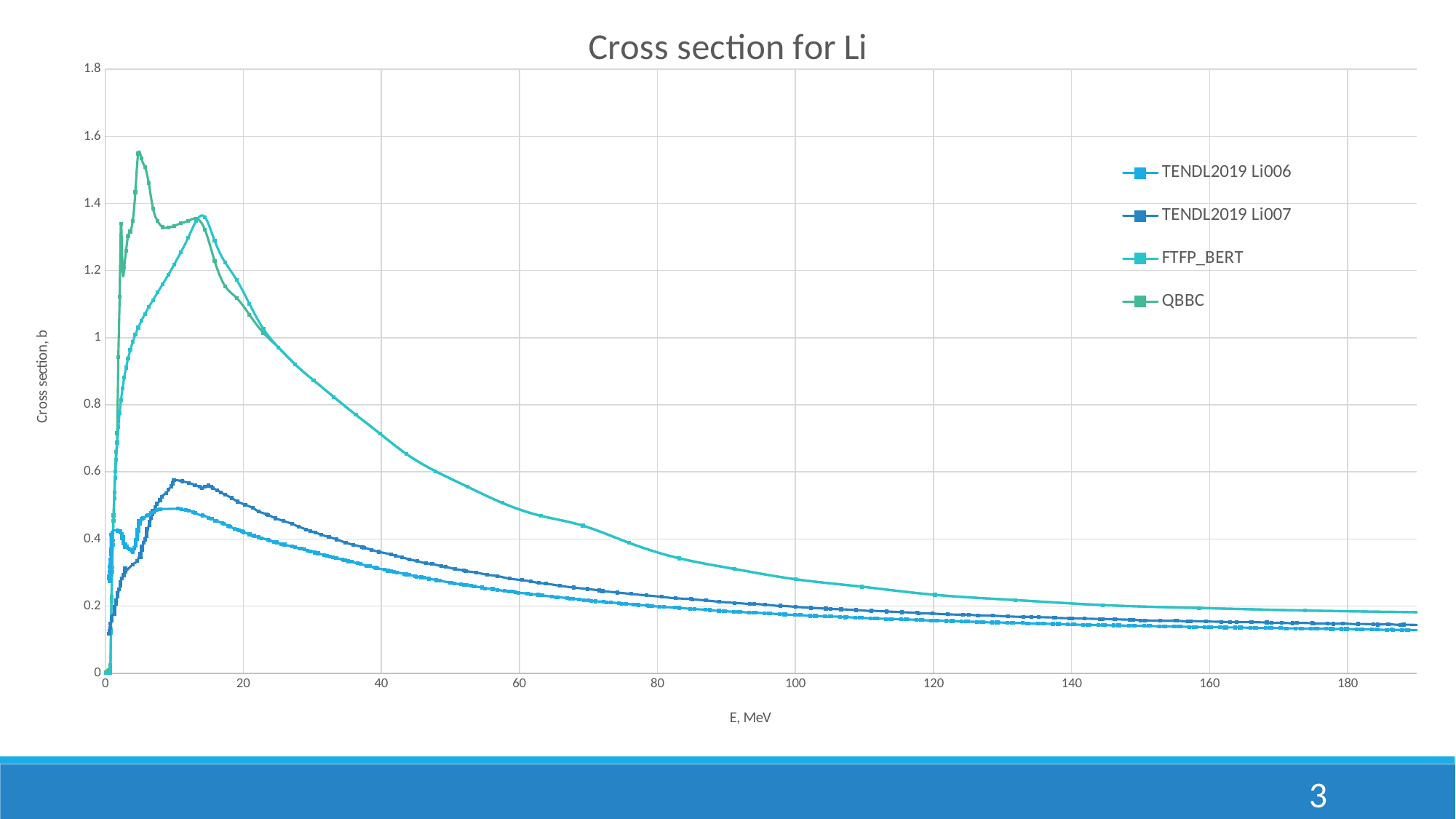
Is the value of FTFP_BERT at 60 MeV greater or less than 0.4? greater Which series has the lowest value at 180 MeV? TENDL2019 Li006 What is the label of the vertical axis? Cross section, b What kind of chart is shown on the slide? line chart Is the peak value of the QBBC series greater or less than 1.4? greater How many series does the legend list? 4 Is the peak value of the TENDL2019 Li007 series greater or less than 0.4? greater Does the FTFP_BERT series rise or fall between 40 MeV and 180 MeV? fall Which series reaches the highest cross section value on the chart? QBBC What is the title of the chart? Cross section for Li At 100 MeV, which series has the larger value: FTFP_BERT or TENDL2019 Li006? FTFP_BERT